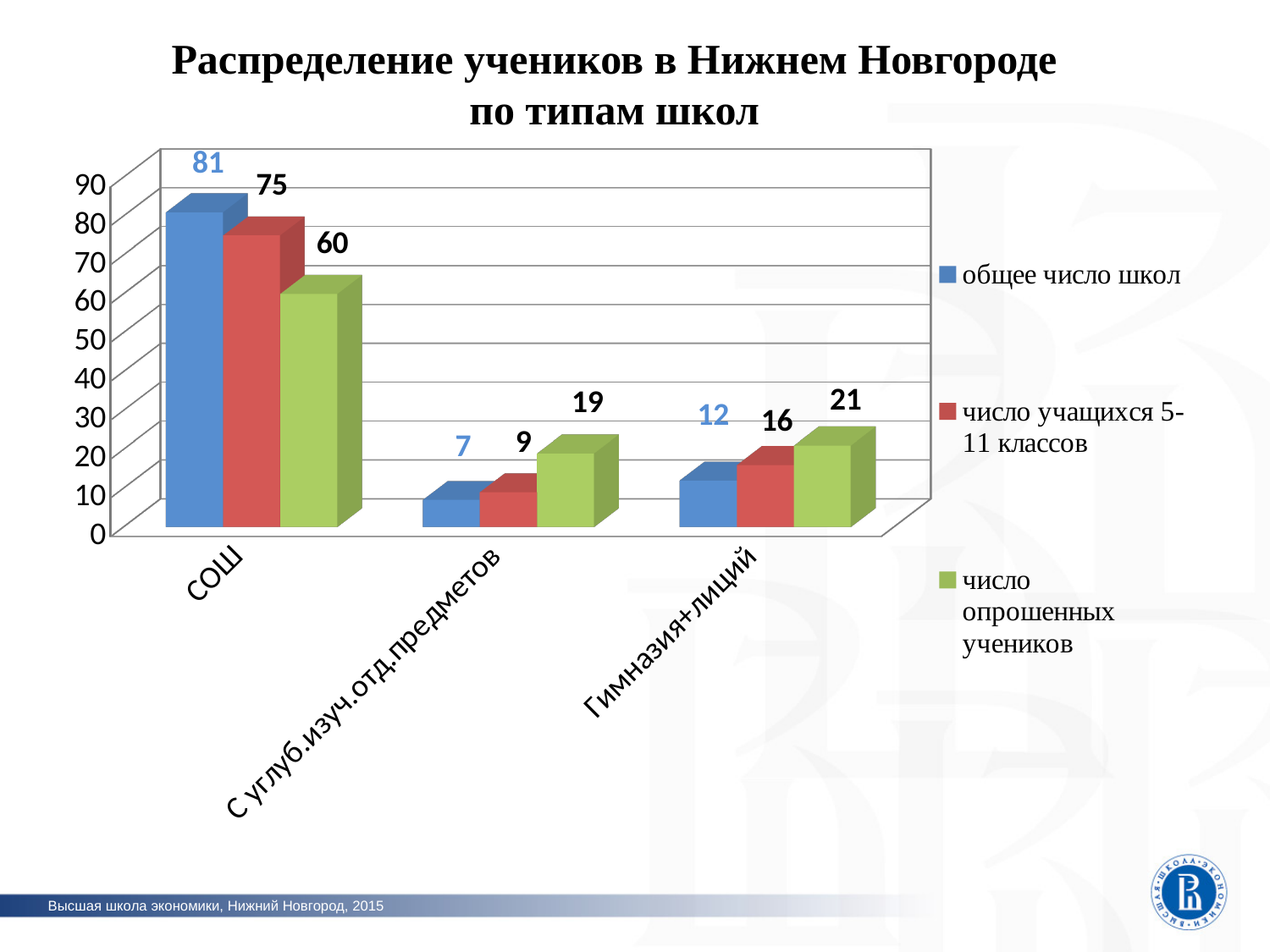
Which school type has the highest value for 'число опрошенных учеников'? СОШ How many series does the legend list? 3 Which school type has the lowest value for 'общее число школ'? С углуб.изуч.отд.предметов What kind of chart is shown on the slide? bar chart How many school types are shown on the x axis? 3 What is the value of 'число опрошенных учеников' for Гимназия+лицей? 21 Which is larger for Гимназия+лицей: 'общее число школ' or 'число учащихся 5-11 классов'? число учащихся 5-11 классов What is the value of 'общее число школ' for СОШ? 81 Is the value of 'число учащихся 5-11 классов' for СОШ greater or less than 70? greater What is the difference between 'общее число школ' and 'число опрошенных учеников' for СОШ? 21 What is the value of 'число учащихся 5-11 классов' for 'С углуб.изуч.отд.предметов'? 9 What colour represents 'число опрошенных учеников' in the legend? green